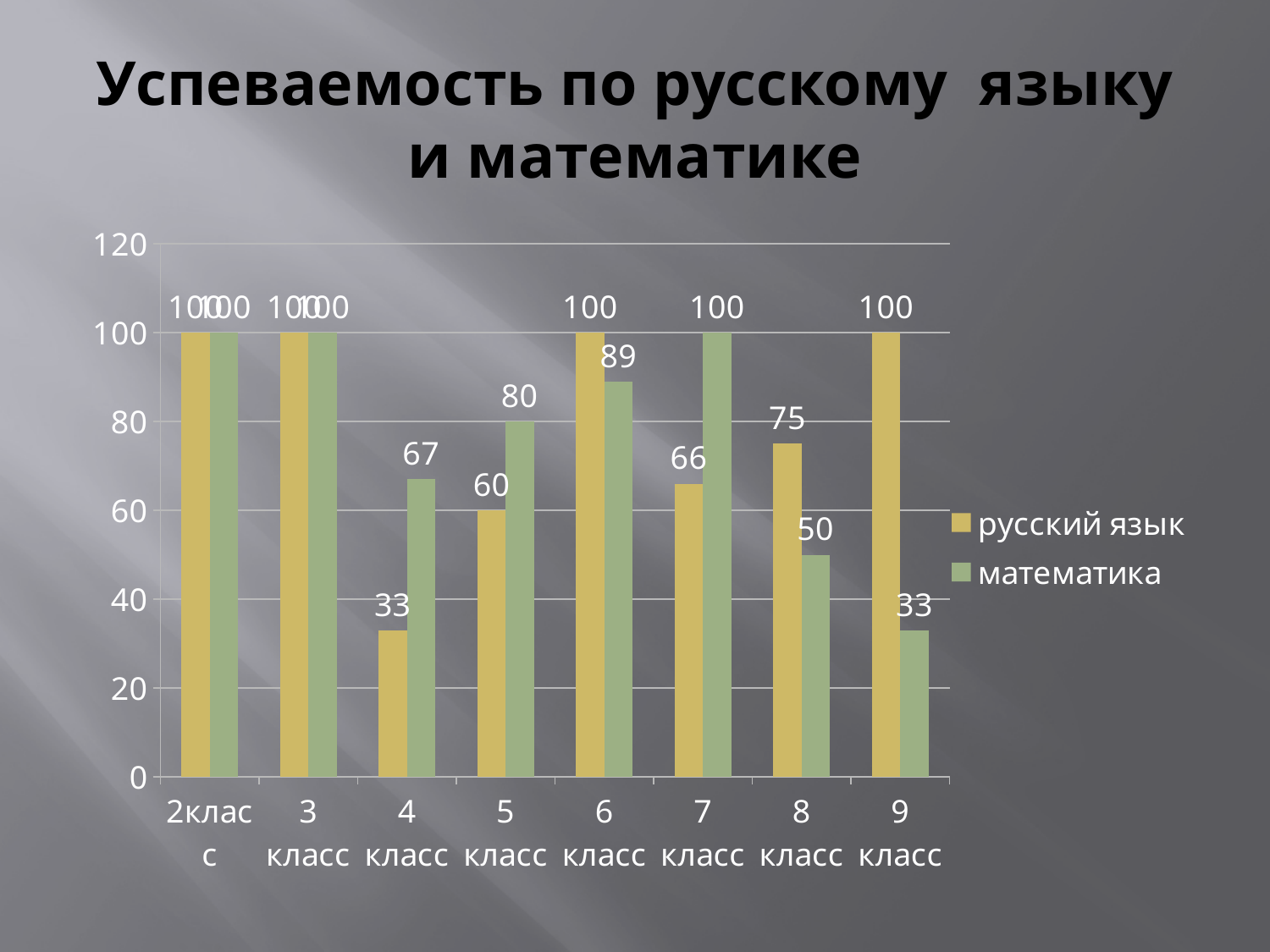
Which class has the lowest value for математика? 9 класс How many class categories are shown on the x axis? 8 What is the value for математика in 9 класс? 33 Which series is shown in green in the legend? математика Which class has the lowest value for русский язык? 4 класс What type of chart is shown on the slide? bar chart What is the value for русский язык in 4 класс? 33 What is the difference between математика and русский язык in 5 класс? 20 What is the value for математика in 6 класс? 89 What is the value for русский язык in 8 класс? 75 How many series does the legend list? 2 In 8 класс, which is larger: русский язык or математика? русский язык